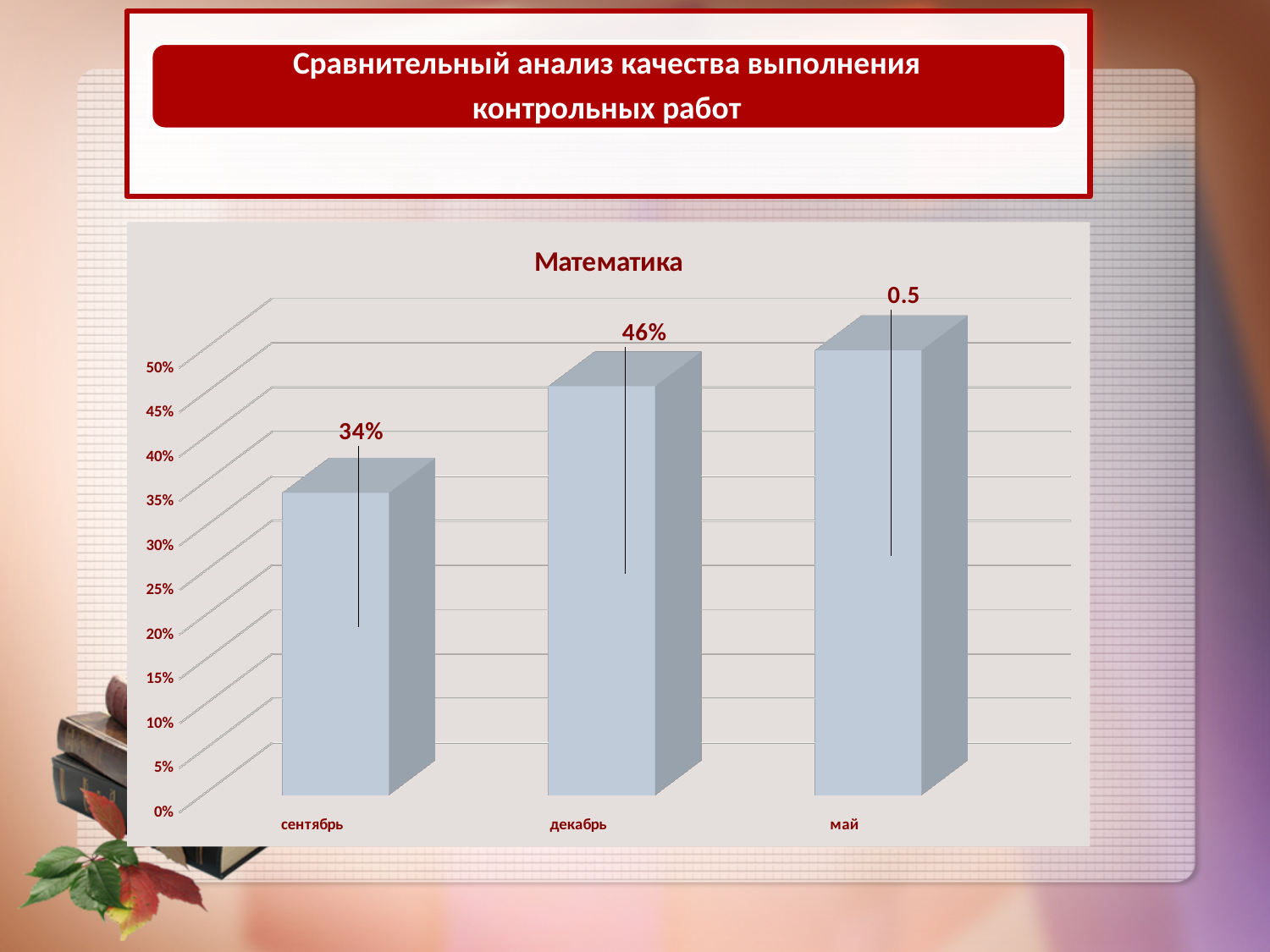
What is the value for декабрь in the Математика chart? 46% How many categories are shown on the x axis of the chart? 3 Which category has the lowest bar in the chart? сентябрь What kind of chart is shown on the slide? bar chart Do the values rise or fall from сентябрь to май? rise Which category has the highest bar in the chart? май Which is larger, the value for сентябрь or the value for декабрь? декабрь What is the title of the chart? Математика Is the value for сентябрь greater or less than 40%? less What is the difference between the values for декабрь and сентябрь? 12% What data label is shown above the bar for май? 0.5 What is the value for сентябрь in the Математика chart? 34%